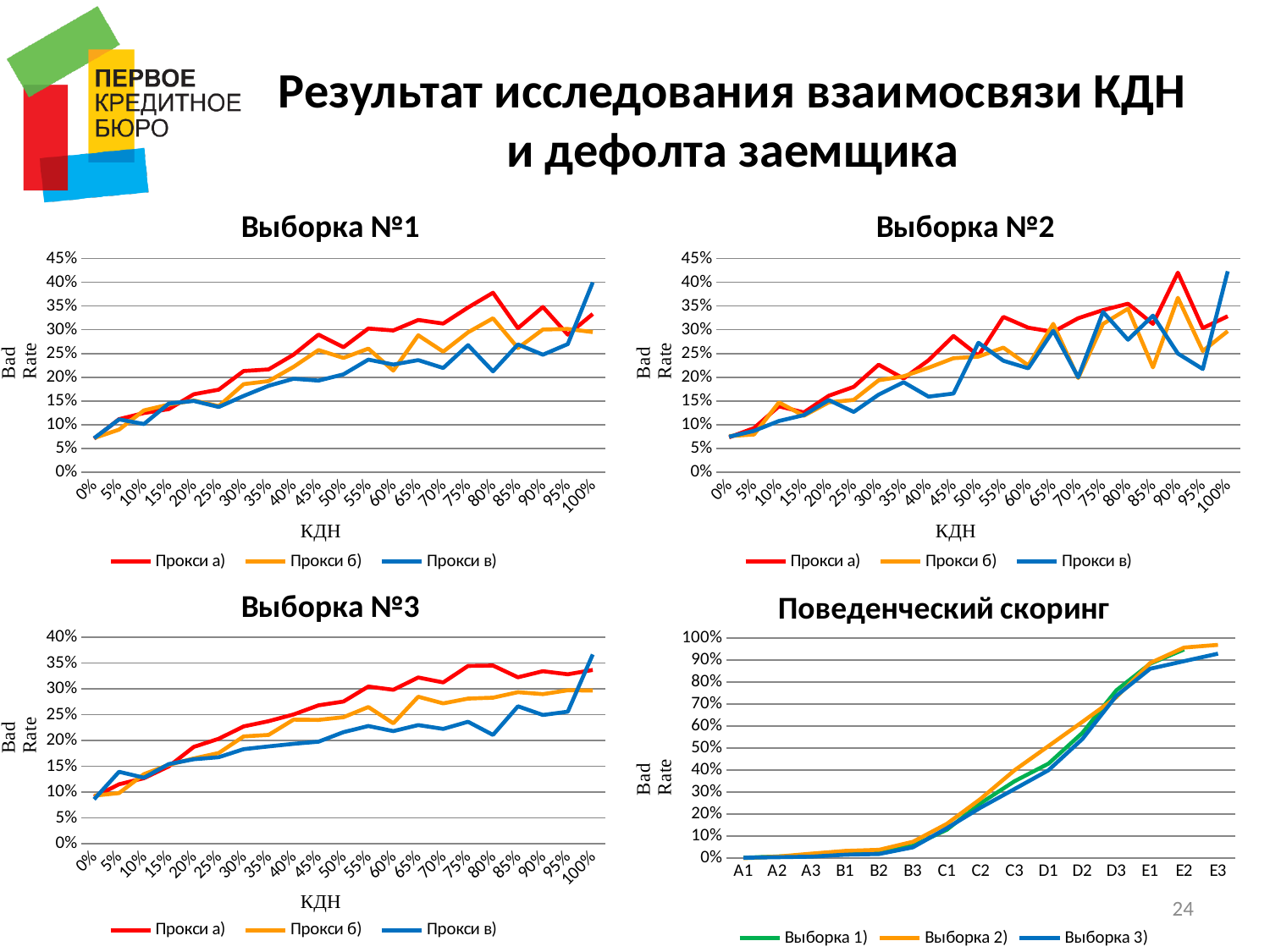
In "Выборка №2", is the value for Прокси в) at КДН 100% greater or less than 40%? greater In "Выборка №1", is the value for Прокси а) at КДН 80% greater or less than 35%? greater In "Выборка №3", which is larger at КДН 80%: Прокси а) or Прокси в)? Прокси а) How many series does the legend of "Выборка №1" list? 3 In "Поведенческий скоринг", is the value for Выборка 2) at E3 greater or less than 90%? greater What kind of chart is "Выборка №1"? line chart What are the three series listed in the legend of "Поведенческий скоринг"? Выборка 1), Выборка 2), Выборка 3) In "Выборка №2", which series is shown in blue? Прокси в) In "Выборка №1", how many points are plotted along the КДН axis for each series? 21 In "Выборка №1", do the Bad Rate values generally rise or fall as КДН increases from 0% to 100%? rise How many categories are on the x axis of "Поведенческий скоринг"? 15